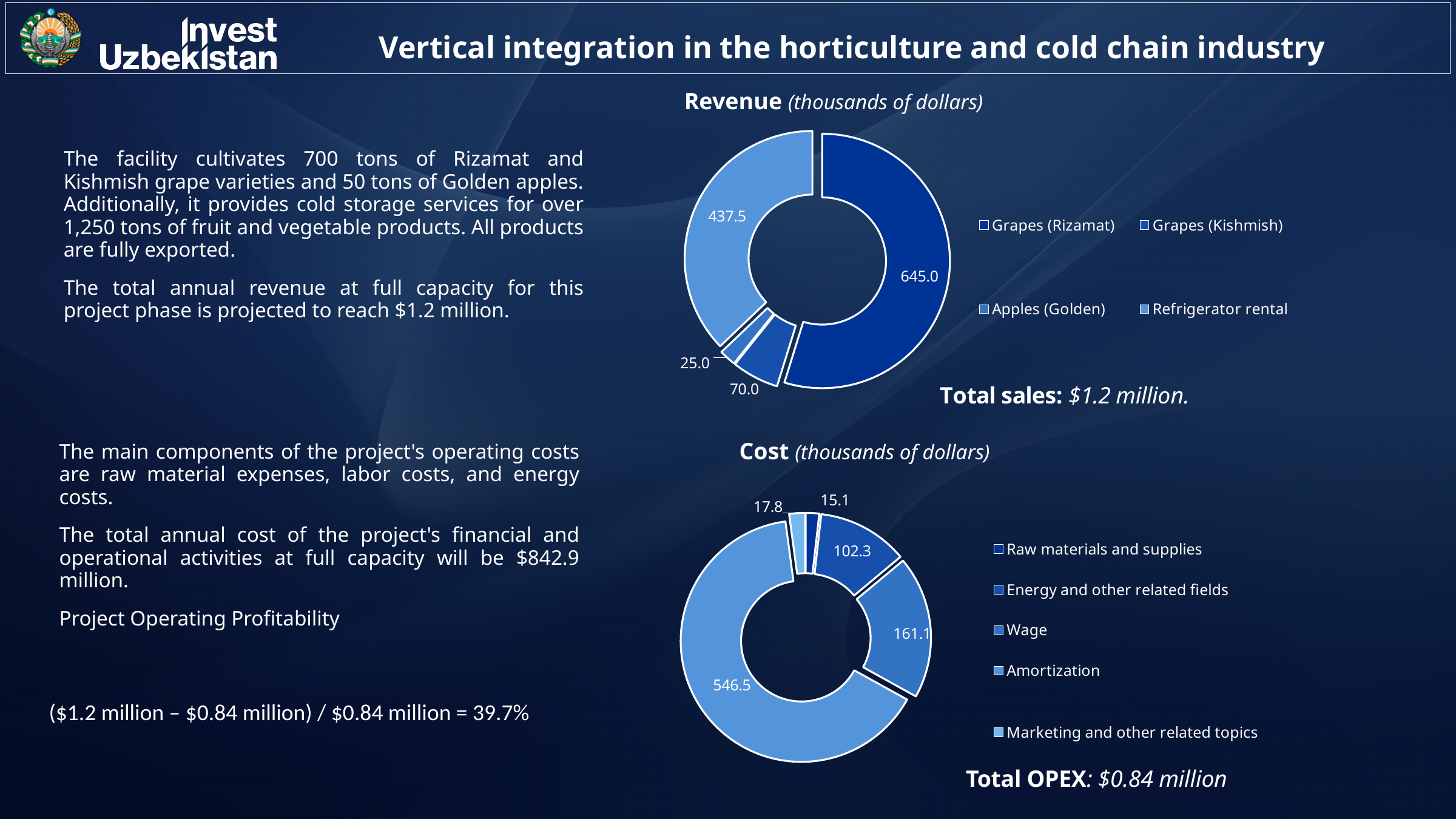
In the Cost chart, what is the smallest value shown? 15.1 In the Revenue chart, how many categories does the legend list? 4 In the Revenue chart, what is the value for Apples (Golden)? 25.0 In the Revenue chart, what is the value for Grapes (Rizamat)? 645.0 In the Cost chart, what is the largest value shown? 546.5 What unit is stated in the title of the Cost chart? thousands of dollars In the Revenue chart, what is the difference between Grapes (Rizamat) and Refrigerator rental? 207.5 In the Cost chart, which is larger, the slice labelled 161.1 or the slice labelled 102.3? 161.1 In the Cost chart, how many categories does the legend list? 5 What type of chart is the Revenue chart? Doughnut chart In the Revenue chart, what is the value for Refrigerator rental? 437.5 In the Revenue chart, which category has the largest value? Grapes (Rizamat)